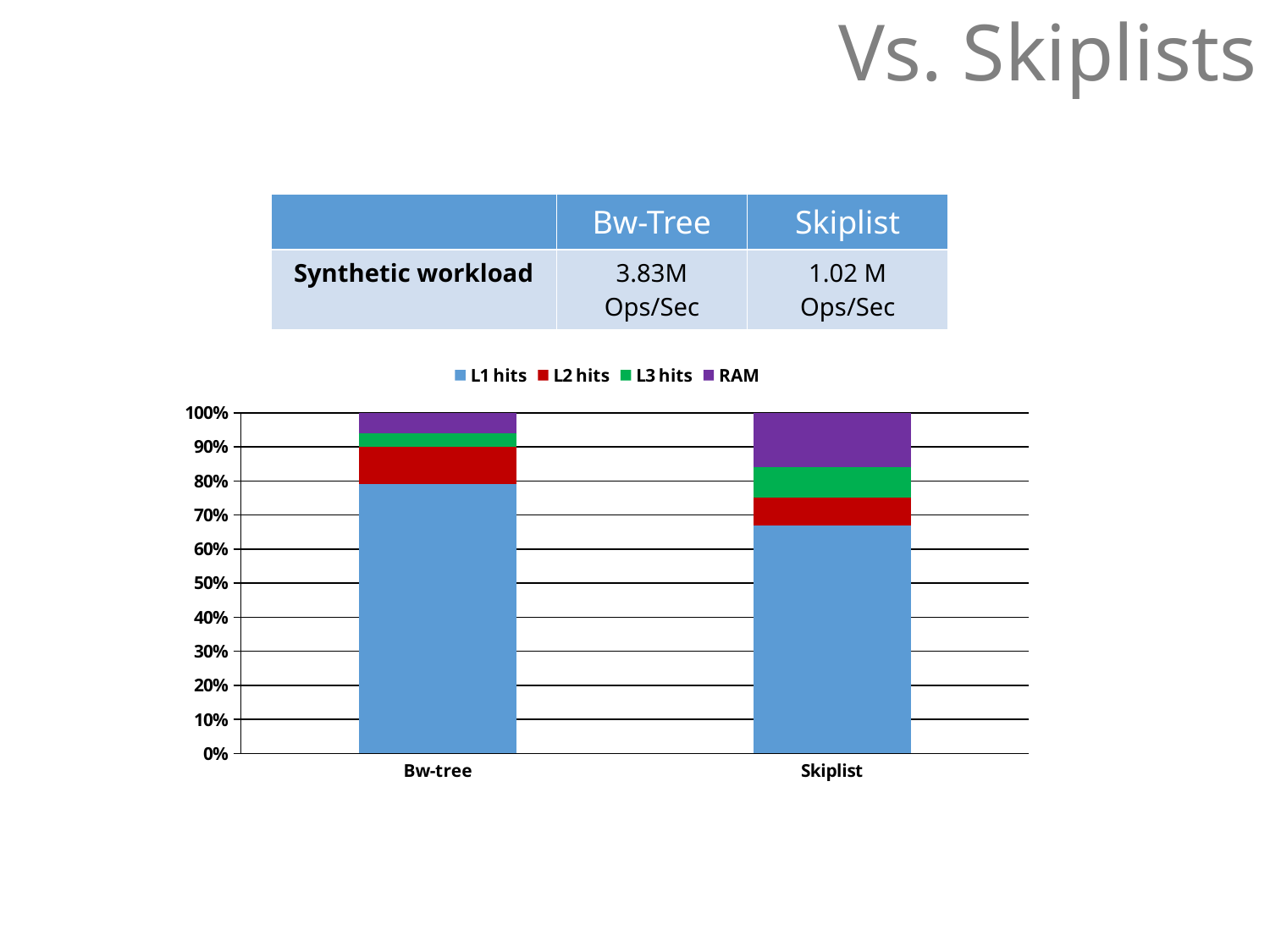
Is the L1 hits share for Skiplist greater or less than 80%? less What are the series listed in the chart legend? L1 hits, L2 hits, L3 hits, RAM How many series does the chart legend list? 4 What is the total height of the stacked bar for Bw-tree? 100% What kind of chart is shown on the slide? Stacked bar chart Is the L1 hits share for Skiplist greater or less than 60%? greater Is the L1 hits share for Bw-tree greater or less than 70%? greater How many categories are shown on the x axis of the chart? 2 Which category has the larger L1 hits share, Bw-tree or Skiplist? Bw-tree Which category has the larger RAM share, Bw-tree or Skiplist? Skiplist Which colour represents RAM in the chart? Purple Which category has the larger L3 hits share, Bw-tree or Skiplist? Skiplist